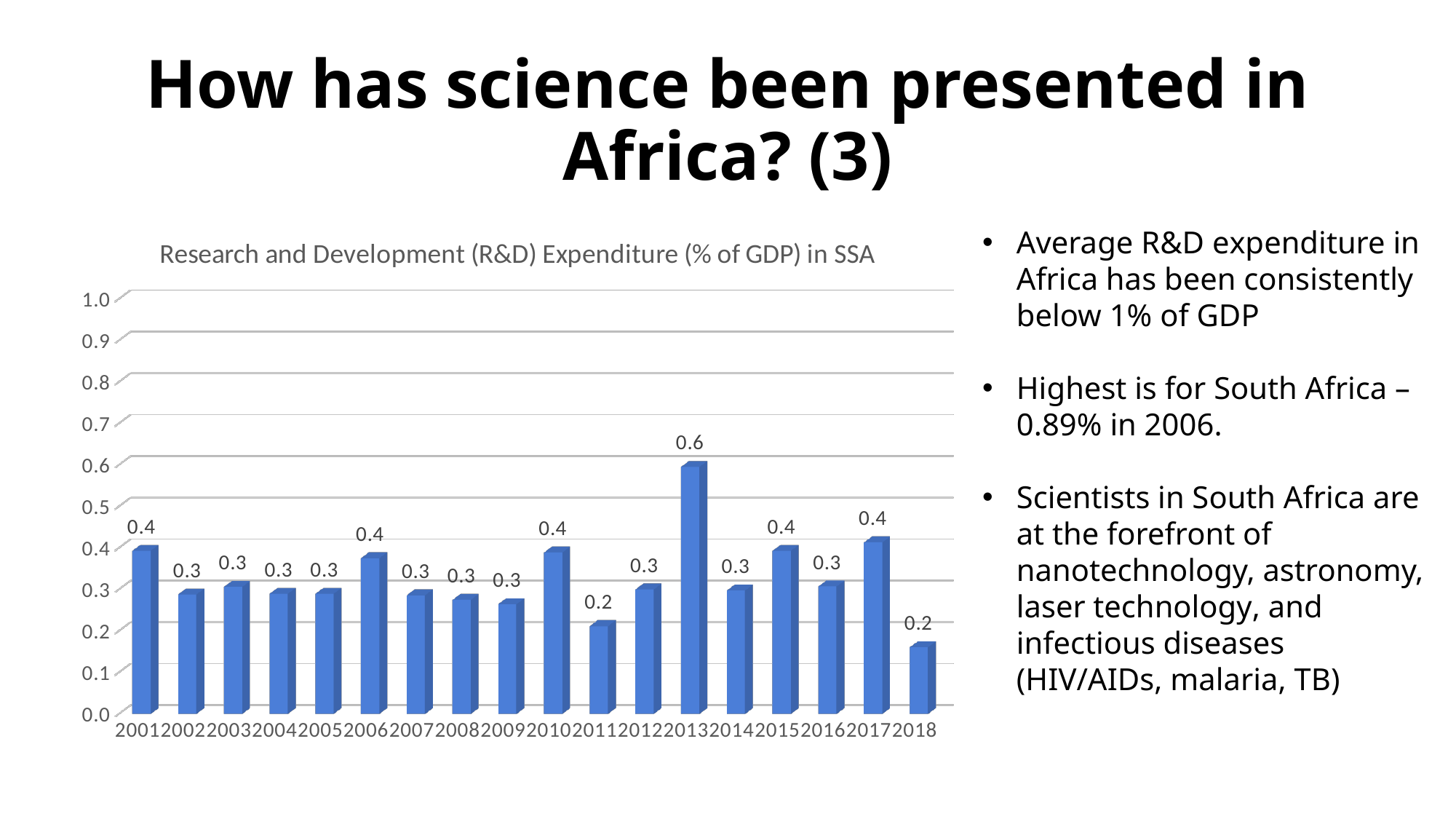
What is the value shown for 2011? 0.2 What is the title of the chart? Research and Development (R&D) Expenditure (% of GDP) in SSA What is the value shown for 2016? 0.3 What is the difference between the values for 2013 and 2011? 0.4 Which year has the highest R&D expenditure value? 2013 What is the value shown for 2001? 0.4 Is the value for 2013 greater or less than 0.5? greater How many years are shown on the x axis of the chart? 18 Which is larger, the value for 2013 or the value for 2001? 2013 Is the value for 2011 greater or less than 0.3? less What is the R&D expenditure value shown for 2013? 0.6 What kind of chart is shown on the slide? Bar chart